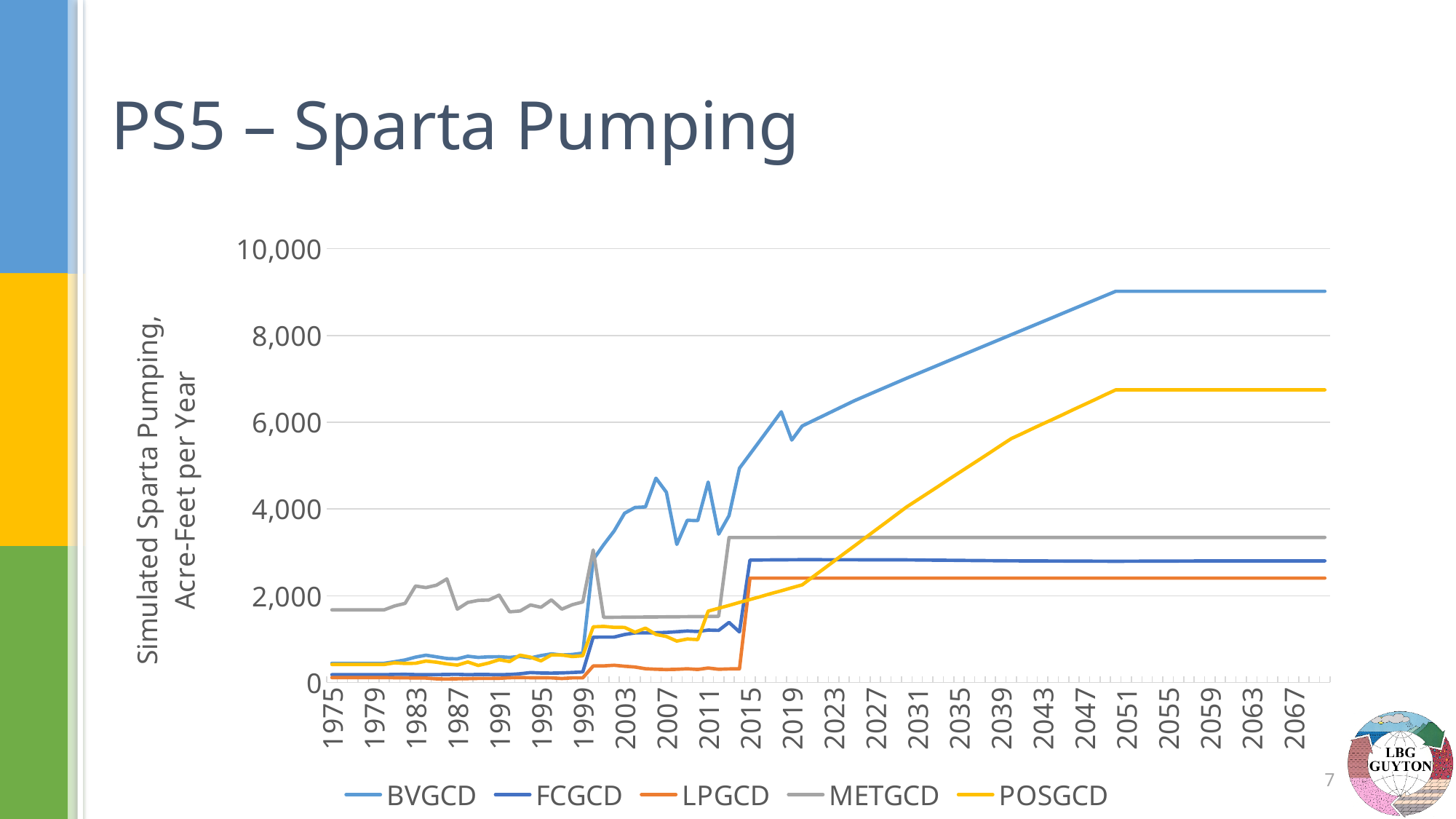
Is the value for METGCD in 2067 greater or less than 4,000? less How many series does the legend list? 5 Does the BVGCD series rise or fall between 2019 and 2051? rise Which series is listed first in the legend? BVGCD In 2067, which is larger: METGCD or FCGCD? METGCD Which series has the lowest value in 2067? LPGCD Which series has the highest value in 2067? BVGCD In 1975, which is larger: METGCD or BVGCD? METGCD What is the title of the vertical axis? Simulated Sparta Pumping, Acre-Feet per Year Is the value for BVGCD in 2067 greater or less than 8,000? greater Is the value for POSGCD in 2067 greater or less than 6,000? greater What kind of chart is shown on the slide? line chart